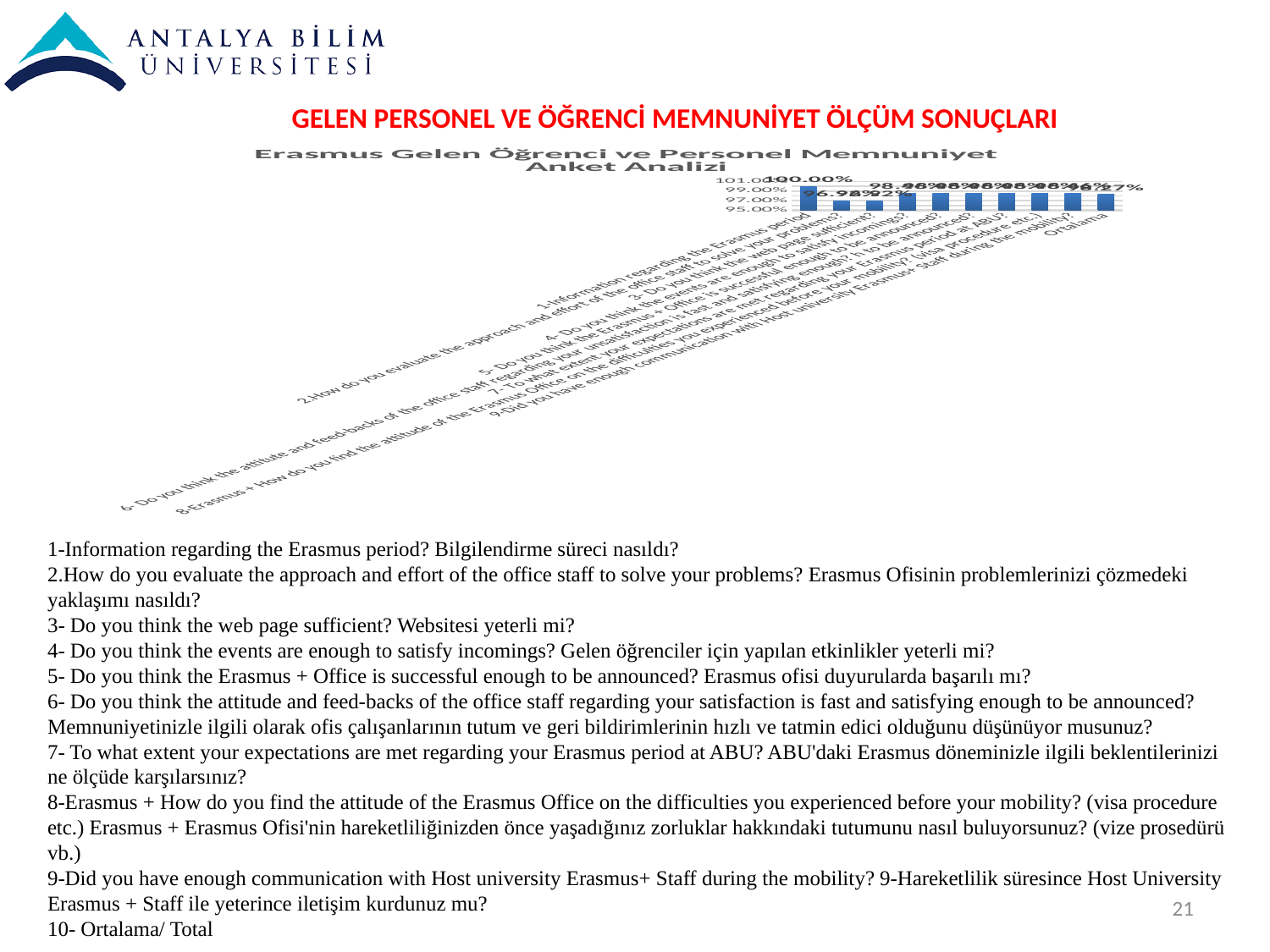
What is the value for the category '1-Information regarding the Erasmus period'? 100.00% Which is larger: the value for '1-Information regarding the Erasmus period' or the value for '2.How do you evaluate the approach and effort of the office staff to solve your problems?'? 1-Information regarding the Erasmus period Is the value for '1-Information regarding the Erasmus period' greater or less than 99.00%? greater What kind of chart is shown on the slide? bar chart How many bars (categories) does the chart show? 10 Which category has the highest value in the chart? 1-Information regarding the Erasmus period What is the label of the last category on the chart's horizontal axis? Ortalama What is the lowest tick value shown on the chart's vertical axis? 95.00% What is the title of the chart on the slide? Erasmus Gelen Öğrenci ve Personel Memnuniyet Anket Analizi